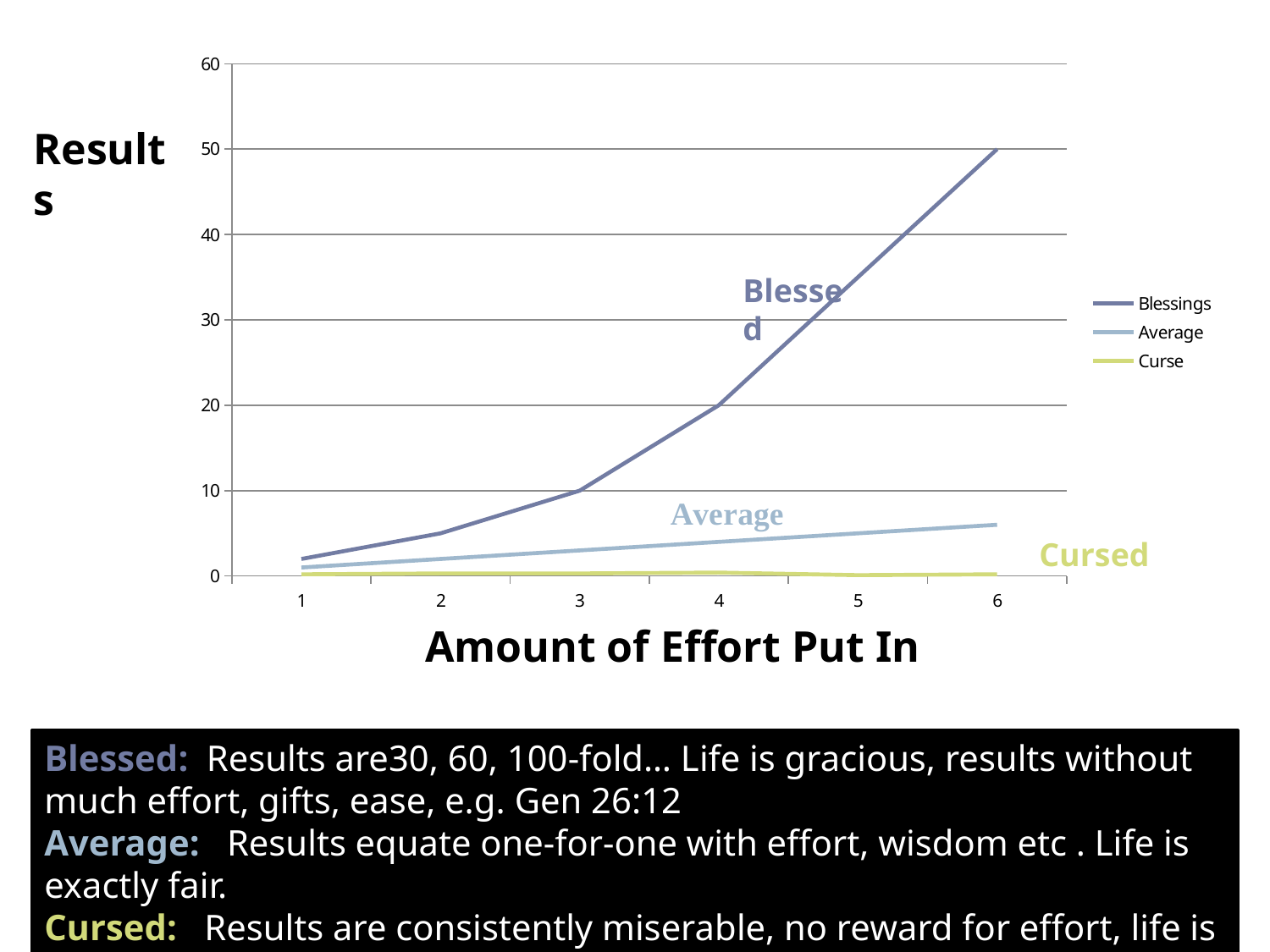
What is the value of the Blessings series at effort level 4? 20 Which series has the highest value at effort level 6? Blessings What is the value of the Blessings series at effort level 3? 10 Which series has the lowest value at effort level 6? Curse What kind of chart is shown on the slide? line chart Does the Blessings series rise or fall as the amount of effort increases? rise How many series does the legend list? 3 How many points are plotted along the x axis for each series? 6 What is the title of the x axis? Amount of Effort Put In What is the value of the Blessings series at effort level 6? 50 Is the value of the Average series at effort level 6 greater or less than 10? less Is the value of the Blessings series at effort level 5 greater or less than 30? greater